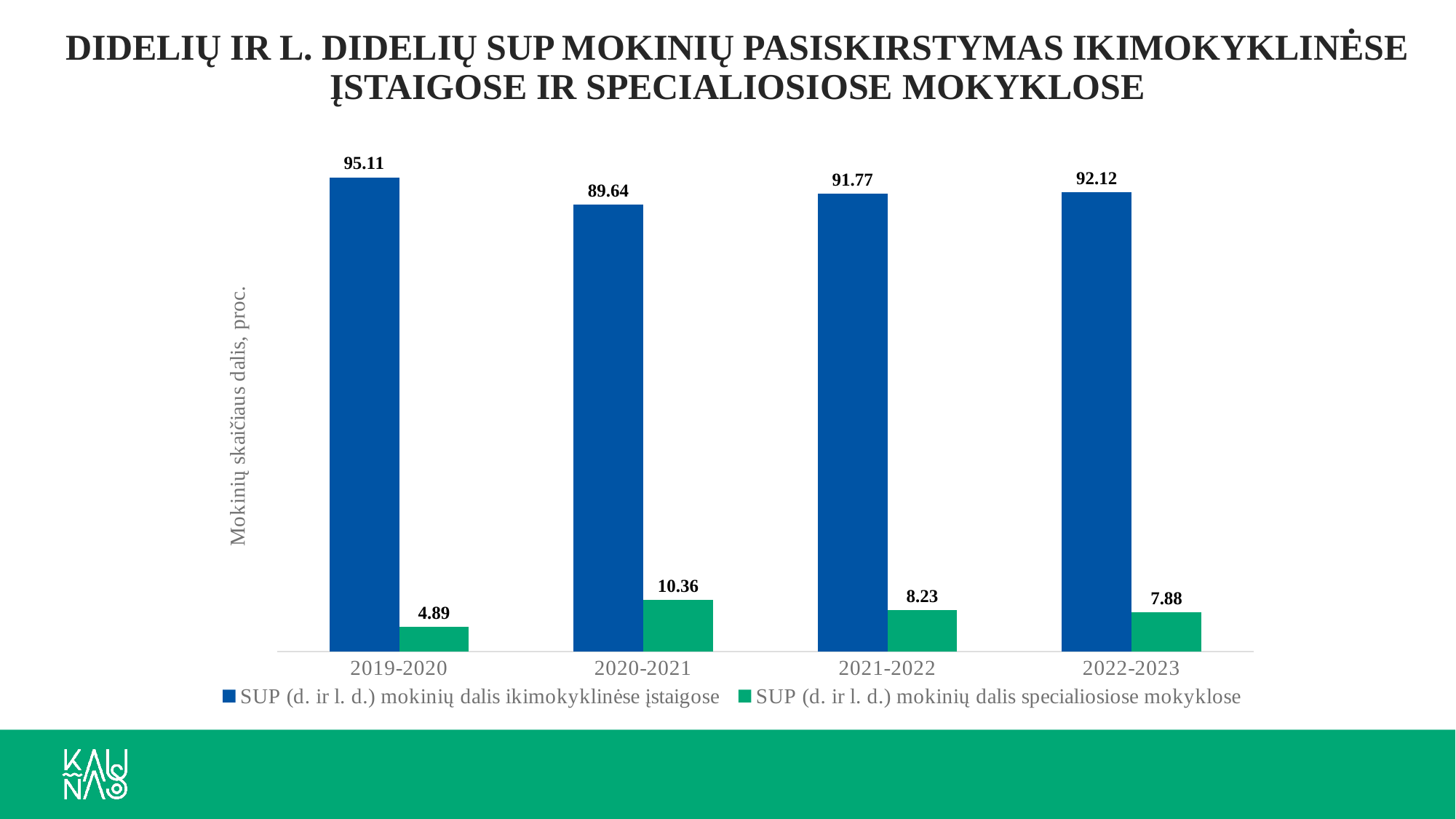
How many school years are shown on the x axis? 4 Which is larger: the value for SUP (d. ir l. d.) mokinių dalis ikimokyklinėse įstaigose in 2021-2022 or in 2022-2023? 2022-2023 What is the value for SUP (d. ir l. d.) mokinių dalis specialiosiose mokyklose in 2020-2021? 10.36 What is the difference between the value for SUP (d. ir l. d.) mokinių dalis specialiosiose mokyklose in 2021-2022 and in 2022-2023? 0.35 In which school year is the value for SUP (d. ir l. d.) mokinių dalis ikimokyklinėse įstaigose the lowest? 2020-2021 What kind of chart is shown on the slide? Bar chart How many series does the legend list? 2 In which school year is the value for SUP (d. ir l. d.) mokinių dalis specialiosiose mokyklose the lowest? 2019-2020 What is the value for SUP (d. ir l. d.) mokinių dalis specialiosiose mokyklose in 2022-2023? 7.88 What is the value for SUP (d. ir l. d.) mokinių dalis ikimokyklinėse įstaigose in 2019-2020? 95.11 What is the difference between the two series' values in 2019-2020? 90.22 In which school year is the value for SUP (d. ir l. d.) mokinių dalis specialiosiose mokyklose the highest? 2020-2021